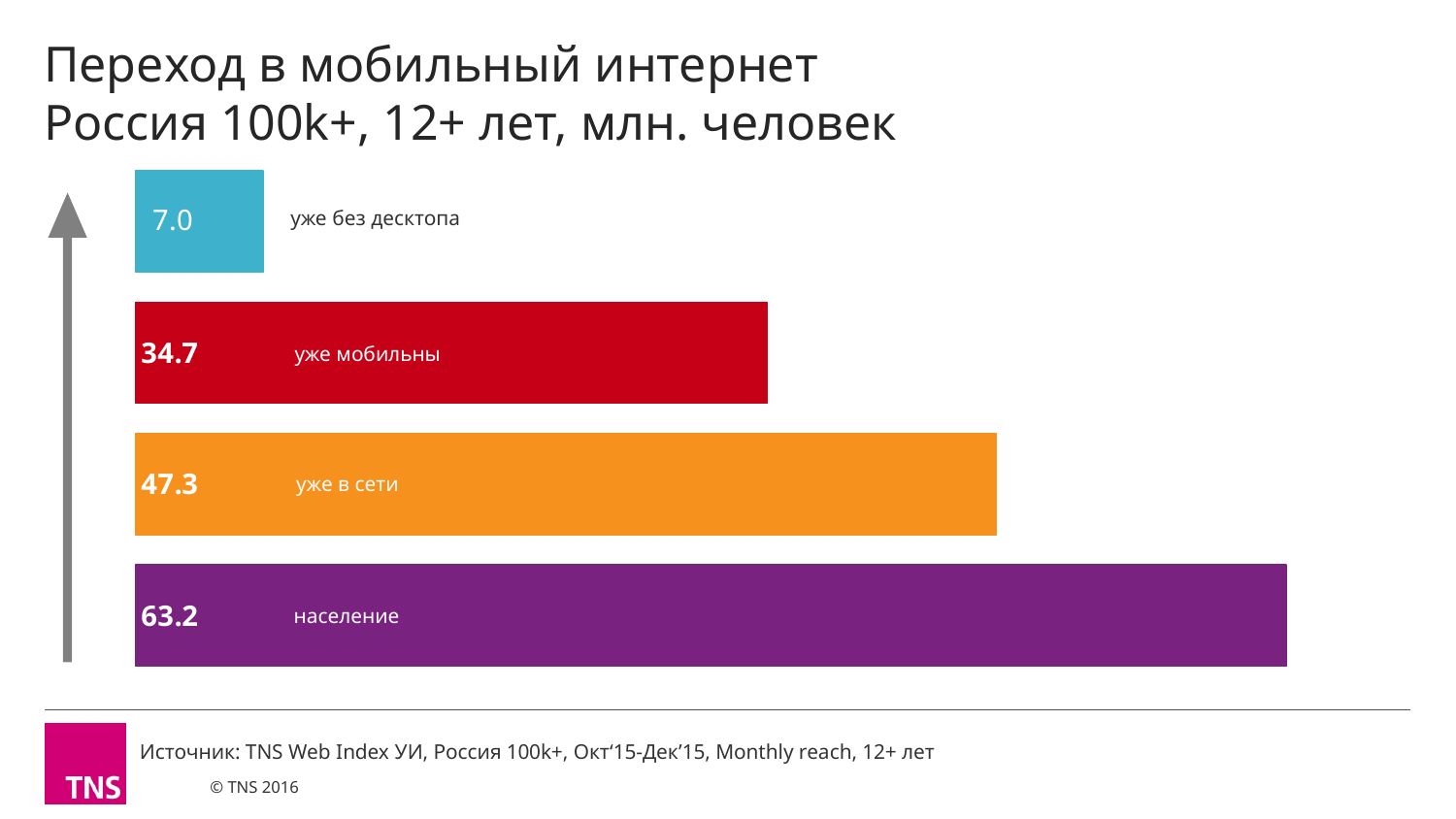
Which category has the highest value? население What is the value for "уже мобильны"? 34.7 What is the value for "уже без десктопа"? 7.0 What is the value for "население"? 63.2 What is the difference between "уже в сети" and "уже мобильны"? 12.6 What is the value for "уже в сети"? 47.3 Which is larger, "уже мобильны" or "уже без десктопа"? уже мобильны Which category has the lowest value? уже без десктопа What is the difference between "население" and "уже в сети"? 15.9 What colour is the bar for "уже в сети"? orange What kind of chart is shown on the slide? bar chart How many categories are shown in the chart? 4